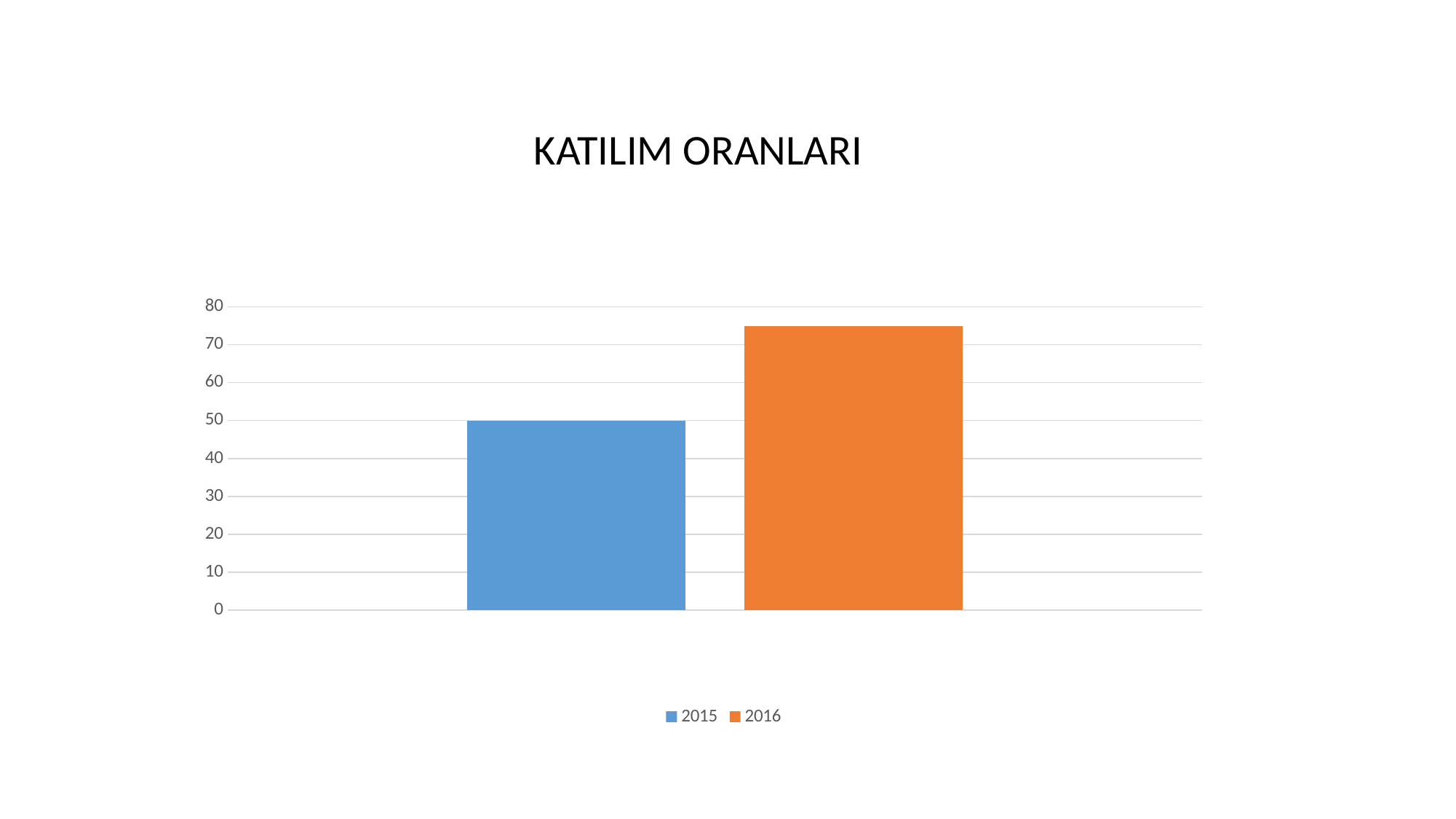
What colour is the bar for 2016? orange Which is larger, the value for 2015 or the value for 2016? 2016 Which series has the highest value? 2016 Which series has the lowest value? 2015 How many bars are plotted in the chart? 2 How many series does the legend list? 2 Is the value for 2016 greater or less than 70? greater Is the value for 2016 greater or less than 80? less What is the value for 2015? 50 What is the title of the chart? KATILIM ORANLARI What kind of chart is shown on the slide? bar chart Is the value for 2015 greater or less than 60? less